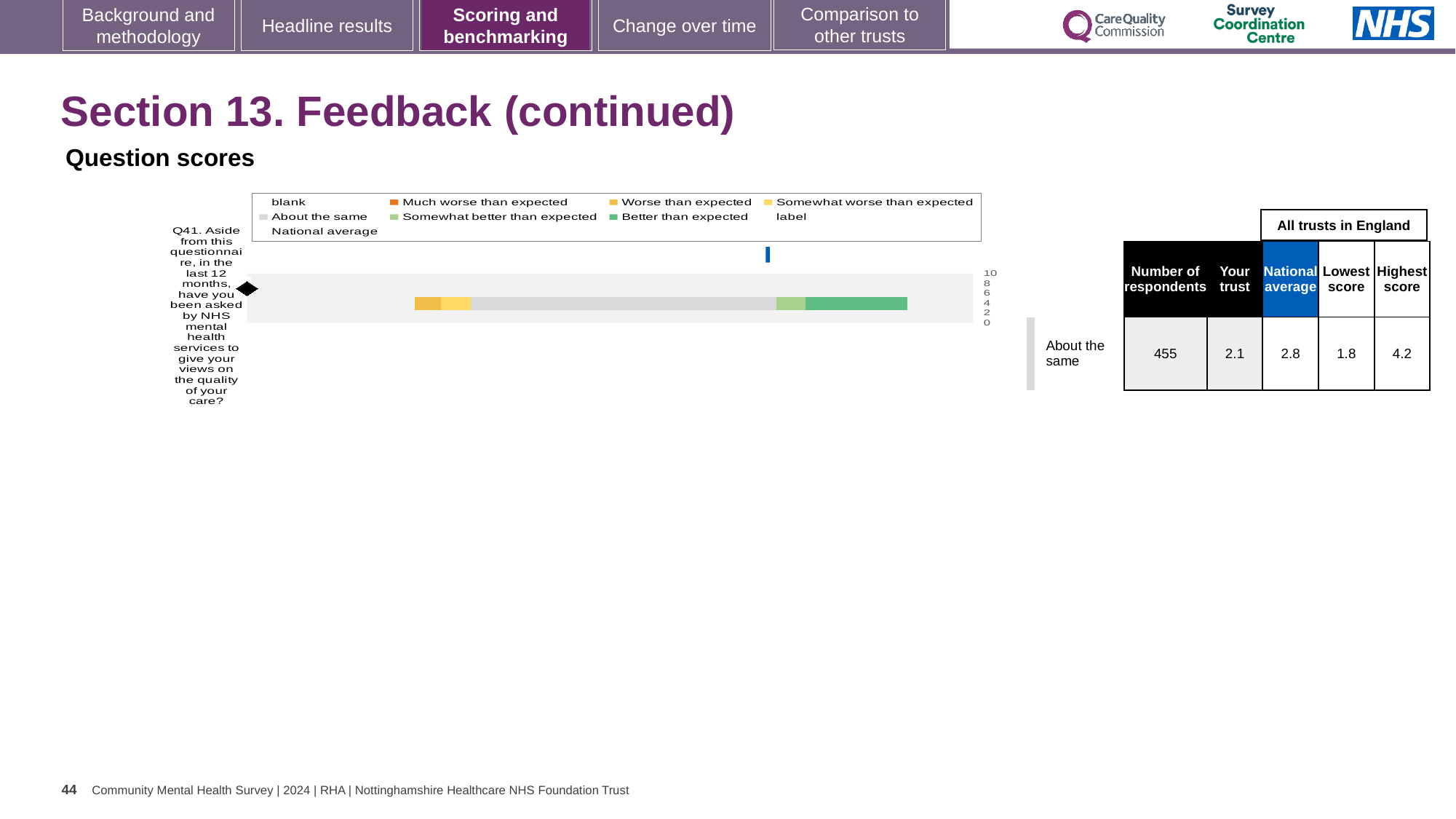
In the table beside the chart, what is the highest score among all trusts in England for Q41? 4.2 In the table beside the chart, what is the national average score for Q41? 2.8 What is the difference between the highest score and the lowest score for Q41 in the table? 2.4 In the table beside the chart, what is the number of respondents for Q41? 455 What kind of chart is shown on the slide? bar chart How many questions (bars) are plotted in the chart? 1 In the table beside the chart, what is the 'Your trust' score for Q41? 2.1 What colour does the legend use for 'Better than expected'? green What benchmark category is shown next to the chart for Q41? About the same Which is larger for Q41, the 'Your trust' score or the national average? National average Which question number is plotted in the chart? Q41 In the table beside the chart, what is the lowest score among all trusts in England for Q41? 1.8